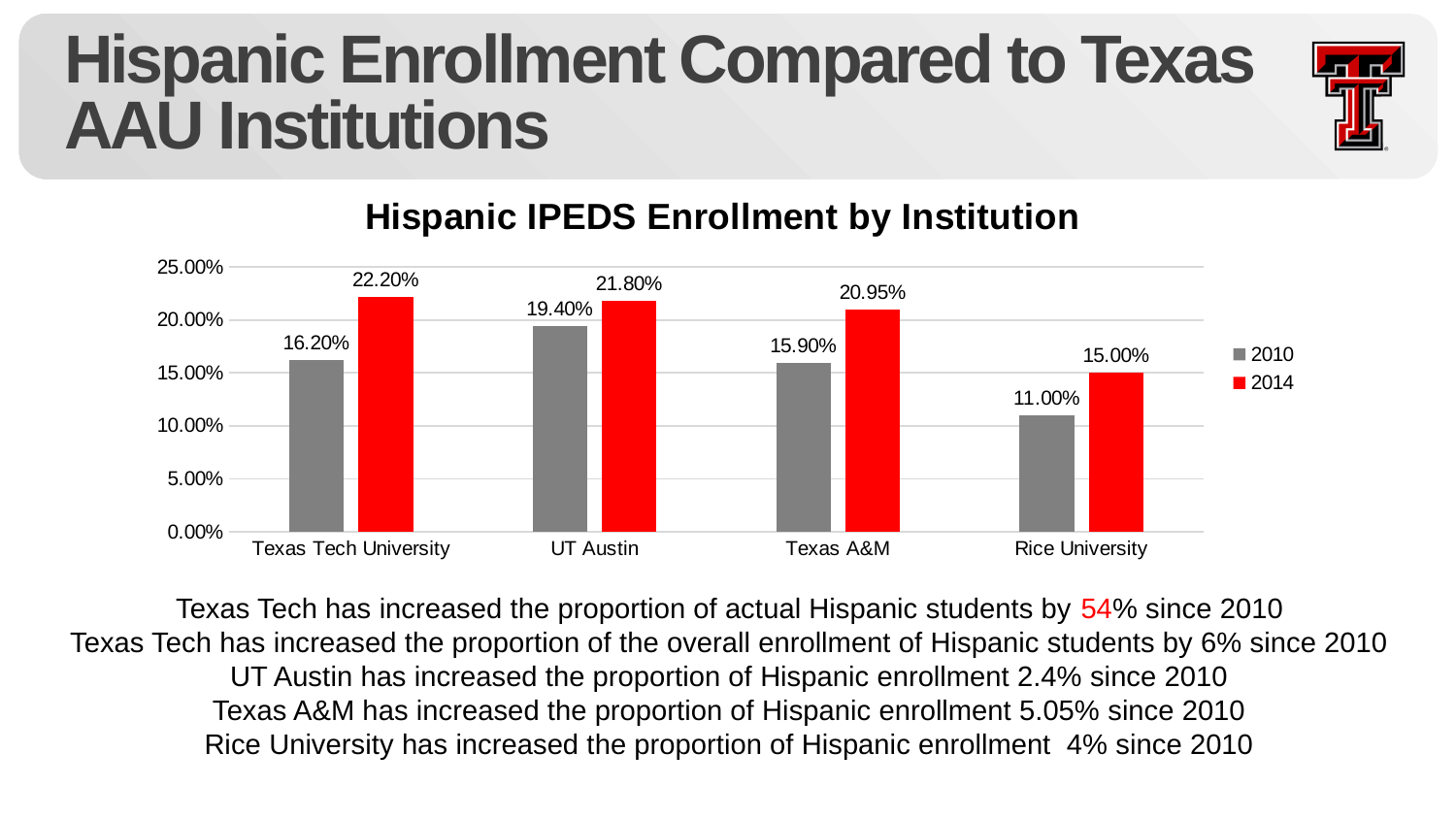
Which institution has the lowest 2010 value? Rice University What kind of chart is shown? Bar chart What is the title of the chart? Hispanic IPEDS Enrollment by Institution What is the 2014 Hispanic enrollment value for Texas Tech University? 22.20% Which is larger: the 2010 value for UT Austin or the 2010 value for Texas A&M? UT Austin How many institutions are shown on the x axis? 4 How many series does the legend list? 2 Which institution has the highest 2014 value? Texas Tech University What is the 2010 Hispanic enrollment value for Rice University? 11.00% What is the difference between the 2014 and 2010 values for Texas Tech University? 6.00% What is the difference between the 2014 and 2010 values for Texas A&M? 5.05% What is the 2010 value for UT Austin? 19.40%